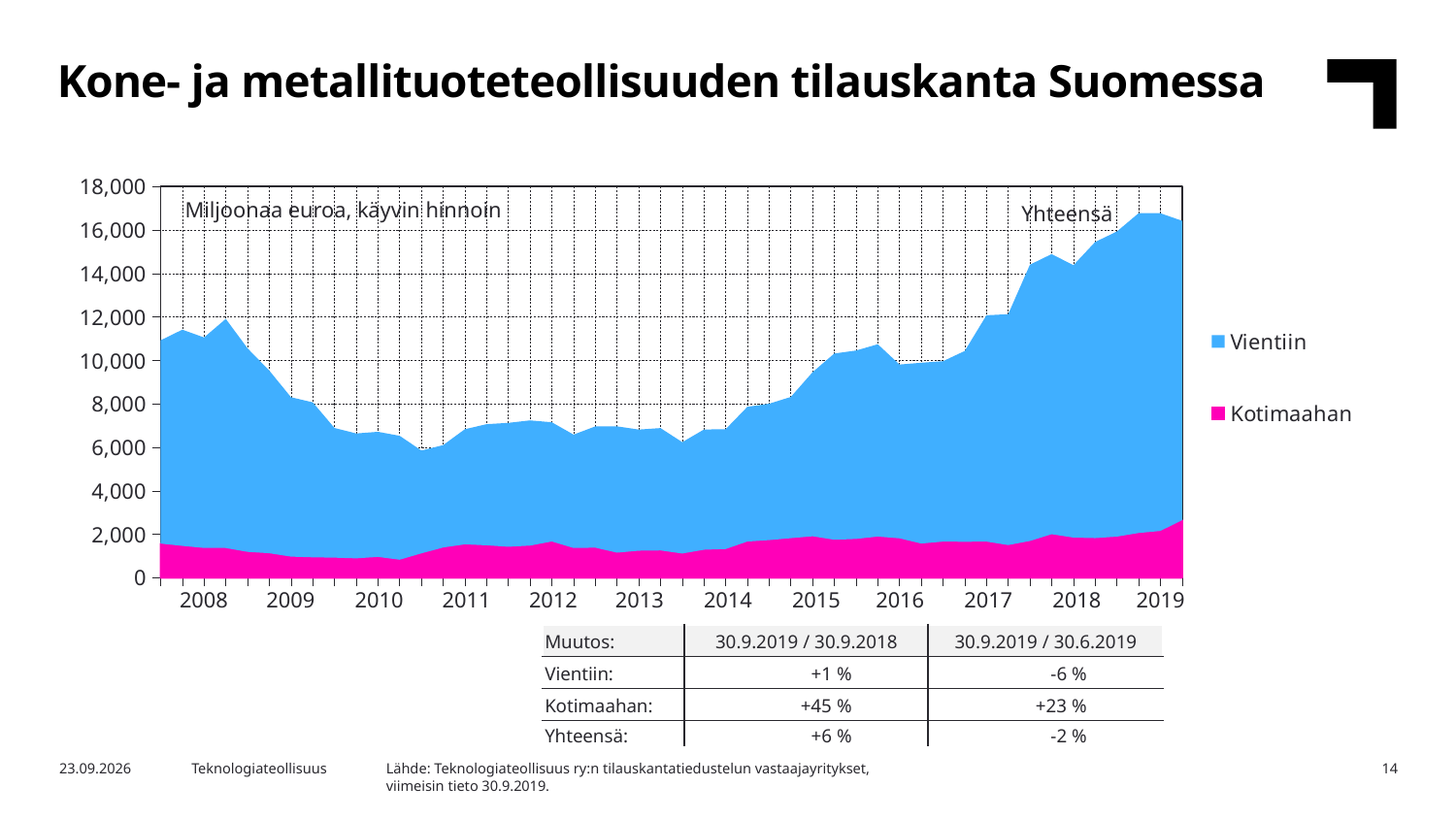
Does the total (Yhteensä) rise or fall between 2016 and 2019? rise Is the total (Yhteensä) value in 2010 greater or less than 8,000? less How many years are labelled on the x axis of the chart? 12 Which series is larger throughout the chart, Vientiin or Kotimaahan? Vientiin What unit label is printed inside the chart area? Miljoonaa euroa, käyvin hinnoin In which year does the total (Yhteensä) reach its highest level? 2019 Is the total (Yhteensä) value at the start of 2008 greater or less than 10,000? greater What kind of chart is shown on the slide? Stacked area chart Is the total (Yhteensä) value at the end of 2019 greater or less than 14,000? greater What are the two series named in the chart legend? Vientiin and Kotimaahan How many series does the chart legend list? 2